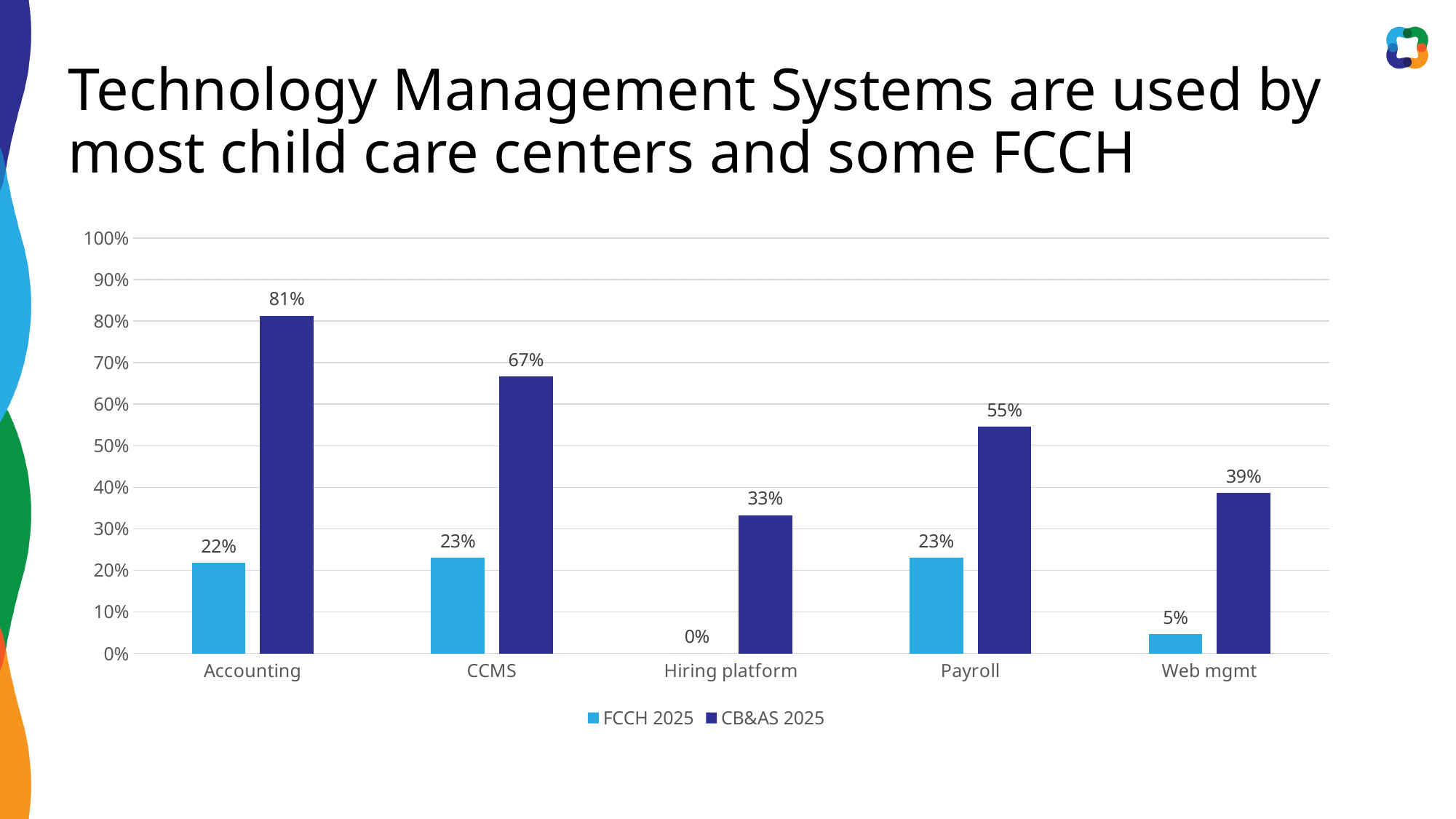
What is the CB&AS 2025 value for Accounting? 81% Which series is shown in dark blue in the legend? CB&AS 2025 Which is larger for Web mgmt: the FCCH 2025 value or the CB&AS 2025 value? CB&AS 2025 What is the difference between the CB&AS 2025 and FCCH 2025 values for CCMS? 44% What is the CB&AS 2025 value for Payroll? 55% What kind of chart is shown on the slide? Bar chart Which category has the lowest FCCH 2025 value? Hiring platform What is the FCCH 2025 value for Web mgmt? 5% How many series does the legend list? 2 What is the FCCH 2025 value for Hiring platform? 0% How many categories are shown on the x axis? 5 Which category has the highest CB&AS 2025 value? Accounting